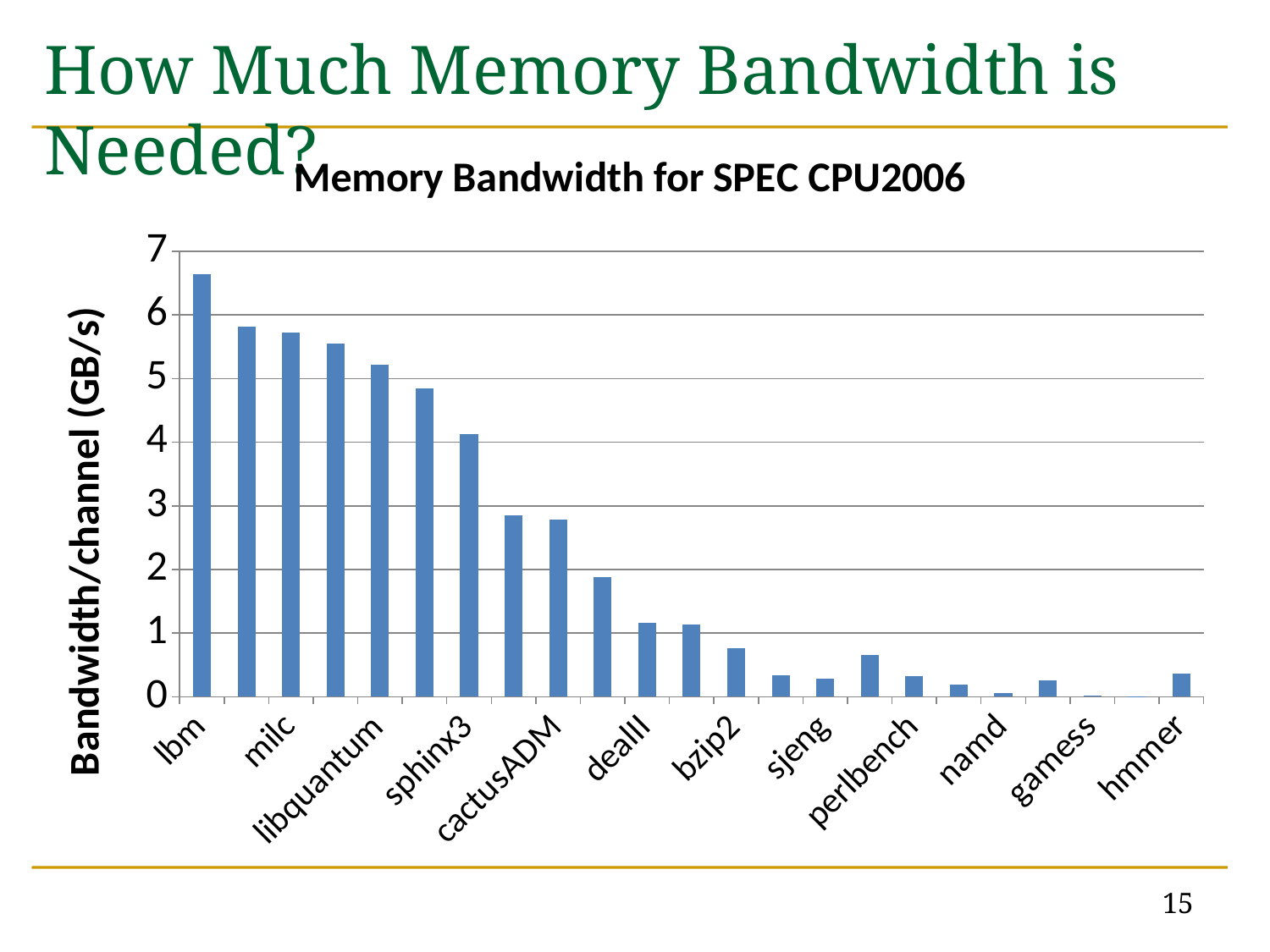
Is the value for milc greater or less than 5? greater Is the value for cactusADM greater or less than 2? greater What is the label of the vertical axis? Bandwidth/channel (GB/s) What type of chart is shown on the slide? bar chart Do the bandwidth values generally rise or fall from left to right along the x axis? fall Is the value for bzip2 greater or less than 1? less What is the title of the chart? Memory Bandwidth for SPEC CPU2006 Which has the larger memory bandwidth, lbm or milc? lbm Which benchmark has the highest memory bandwidth? lbm